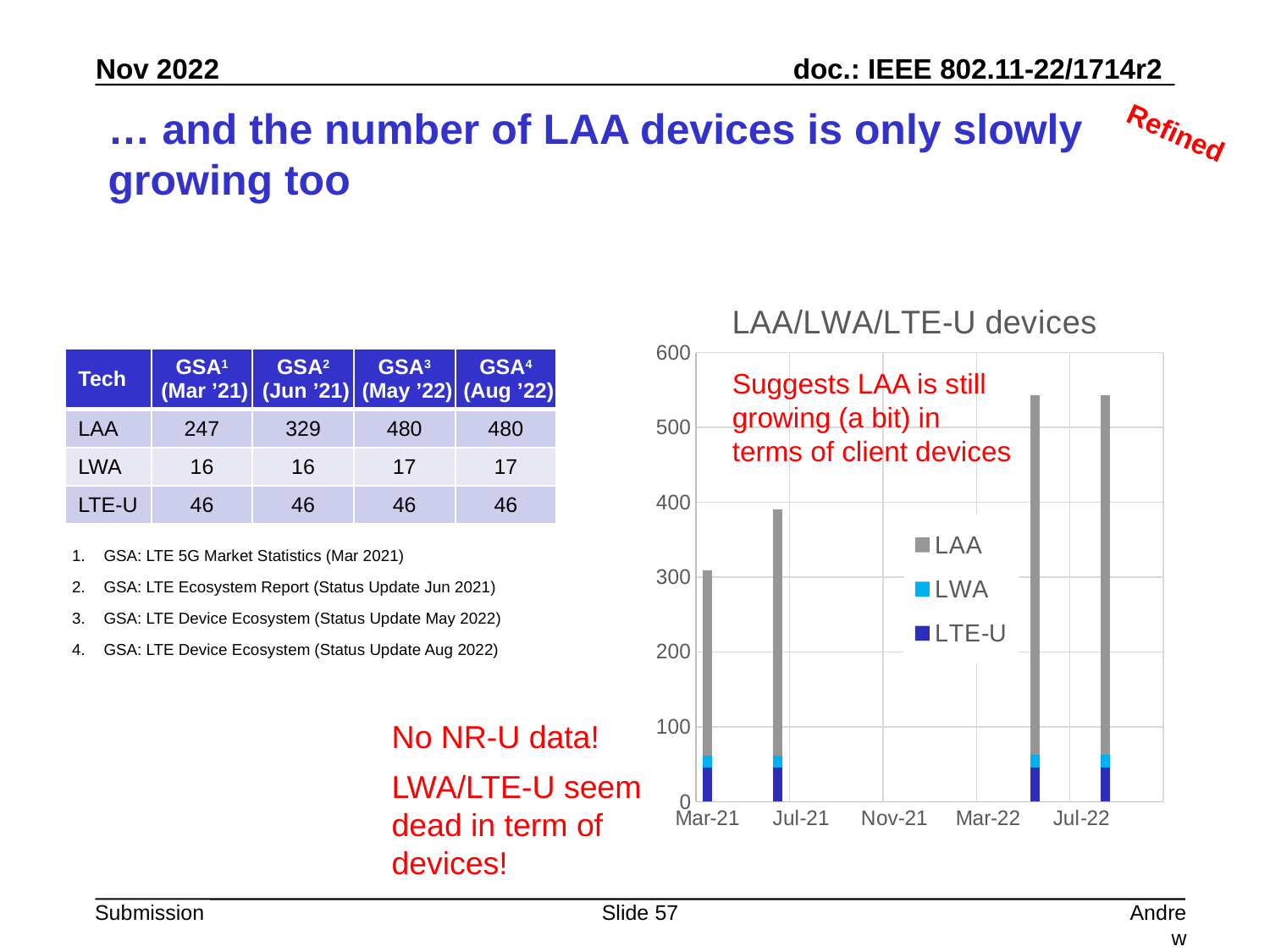
How many bars are plotted in the chart? 4 What kind of chart is shown on the slide? stacked bar chart Is the total height of the last bar (after Jul-22) greater or less than 600? less Which series are listed in the chart legend? LAA, LWA, LTE-U How many series does the chart legend list? 3 What is the title of the chart? LAA/LWA/LTE-U devices Do the total bar heights rise or fall from left to right along the x axis? rise Which is taller, the first bar (Mar-21) or the second bar (near Jul-21)? the second bar (near Jul-21) Is the total height of the first bar (Mar-21) greater or less than 300? greater Which bar has the lowest total height? Mar-21 Is the total height of the bar just after Mar-22 greater or less than 500? greater